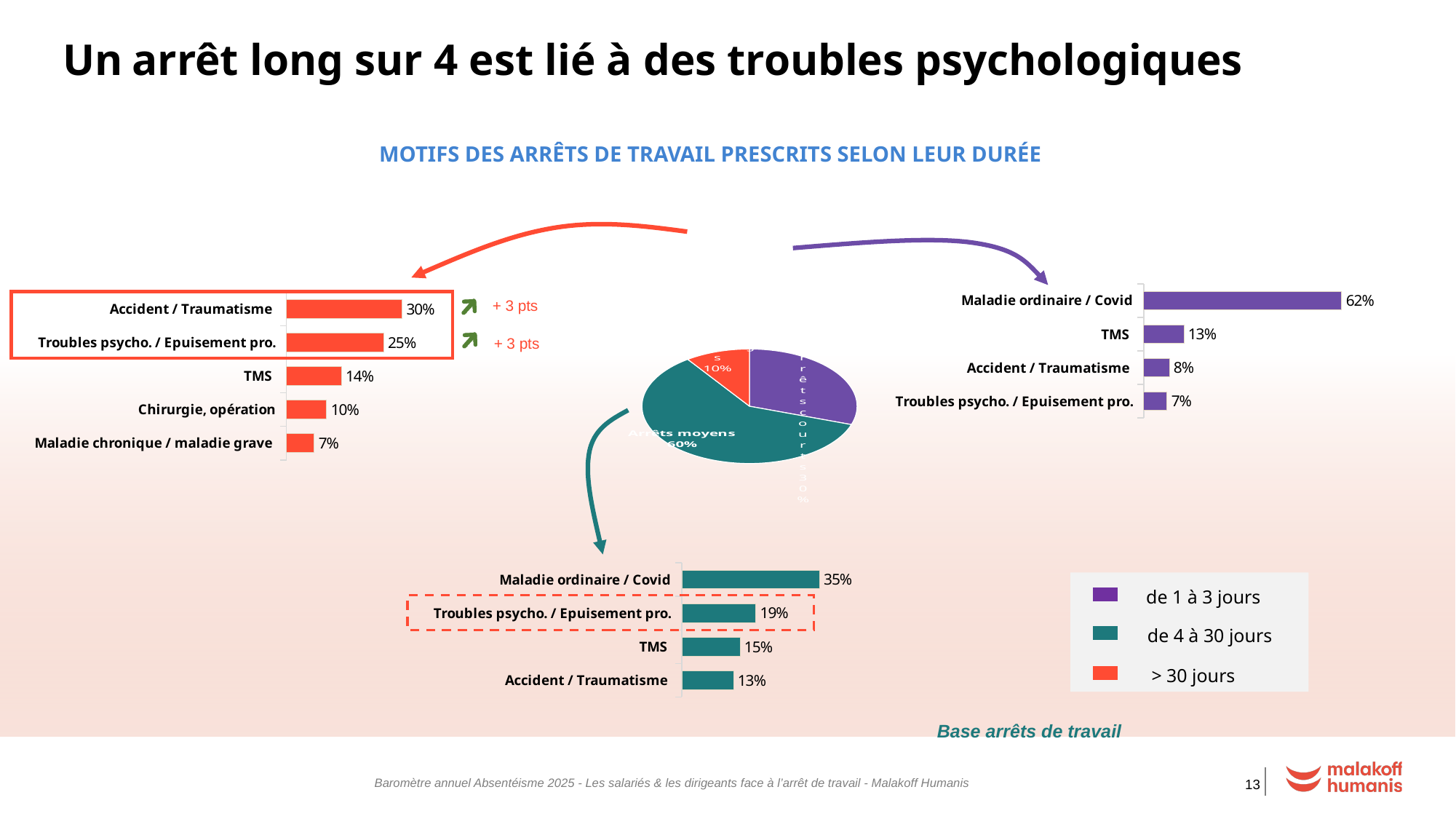
In the red bar chart on the left (> 30 jours), what is the value for Troubles psycho. / Epuisement pro.? 25% In the teal bar chart at the bottom (de 4 à 30 jours), what is the value for Troubles psycho. / Epuisement pro.? 19% In the purple bar chart on the right (de 1 à 3 jours), what is the difference between Maladie ordinaire / Covid and TMS? 49% In the teal bar chart at the bottom (de 4 à 30 jours), how many categories are shown? 4 In the purple bar chart on the right (de 1 à 3 jours), what is the value for Maladie ordinaire / Covid? 62% In the purple bar chart on the right (de 1 à 3 jours), which category has the highest value? Maladie ordinaire / Covid In the red bar chart on the left (> 30 jours), which category has the lowest value? Maladie chronique / maladie grave In the red bar chart on the left (> 30 jours), what is the value for Accident / Traumatisme? 30% In the red bar chart on the left (> 30 jours), how many categories are shown? 5 In the teal bar chart at the bottom (de 4 à 30 jours), which is larger, TMS or Accident / Traumatisme? TMS What kind of chart is the chart in the centre of the slide? Pie chart How many entries does the legend at the bottom right of the slide list? 3